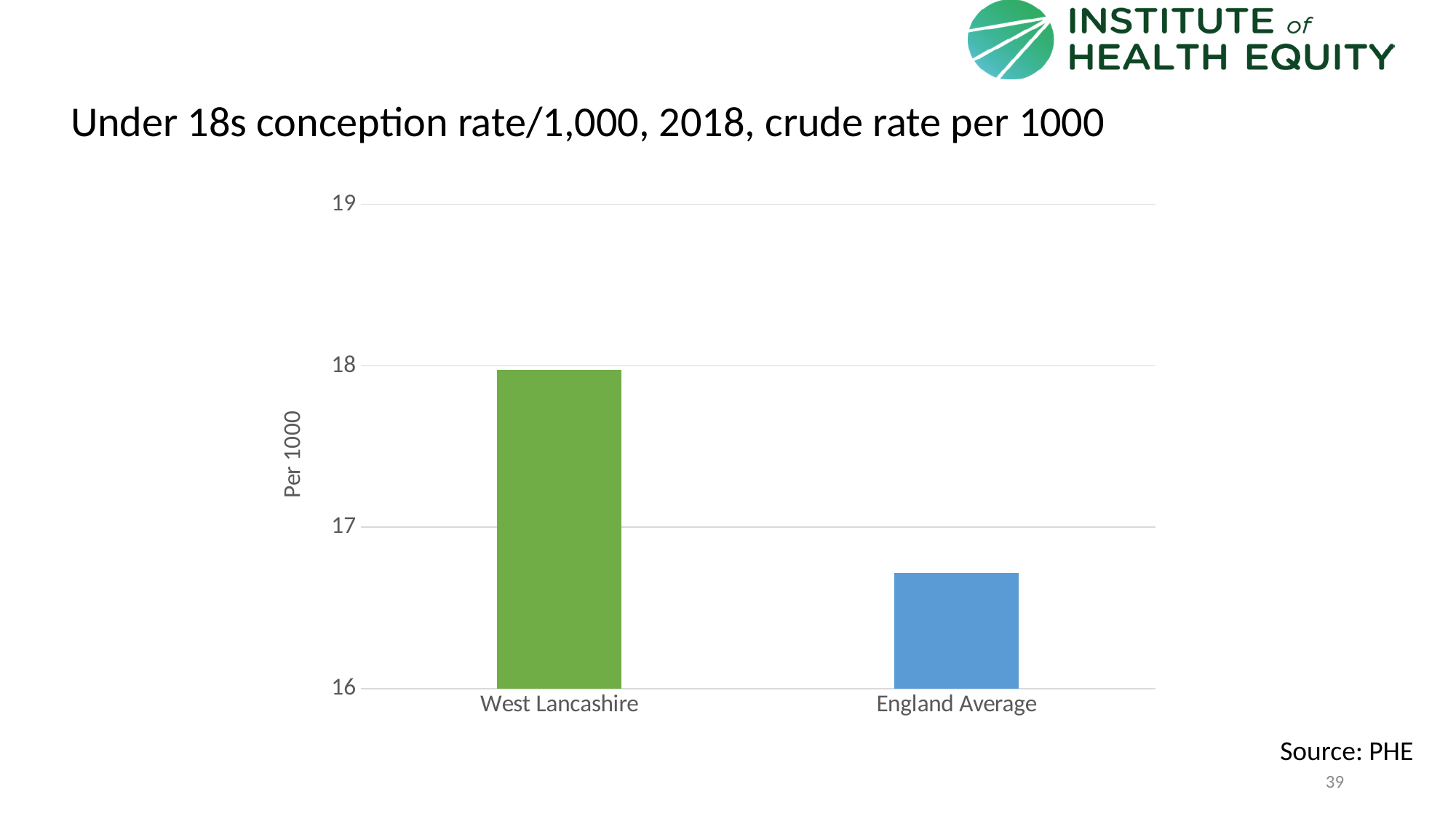
Is the value for West Lancashire greater or less than 17? greater What kind of chart is shown on the slide? bar chart Which category has the highest value in the chart? West Lancashire What is the label on the vertical axis of the chart? Per 1000 Which category has the lowest value in the chart? England Average Is the value for West Lancashire greater or less than the value for England Average? greater Is the value for England Average greater or less than 16? greater What is the title of the chart on the slide? Under 18s conception rate/1,000, 2018, crude rate per 1000 Is the value for England Average greater or less than 17? less How many categories are shown on the x axis of the chart? 2